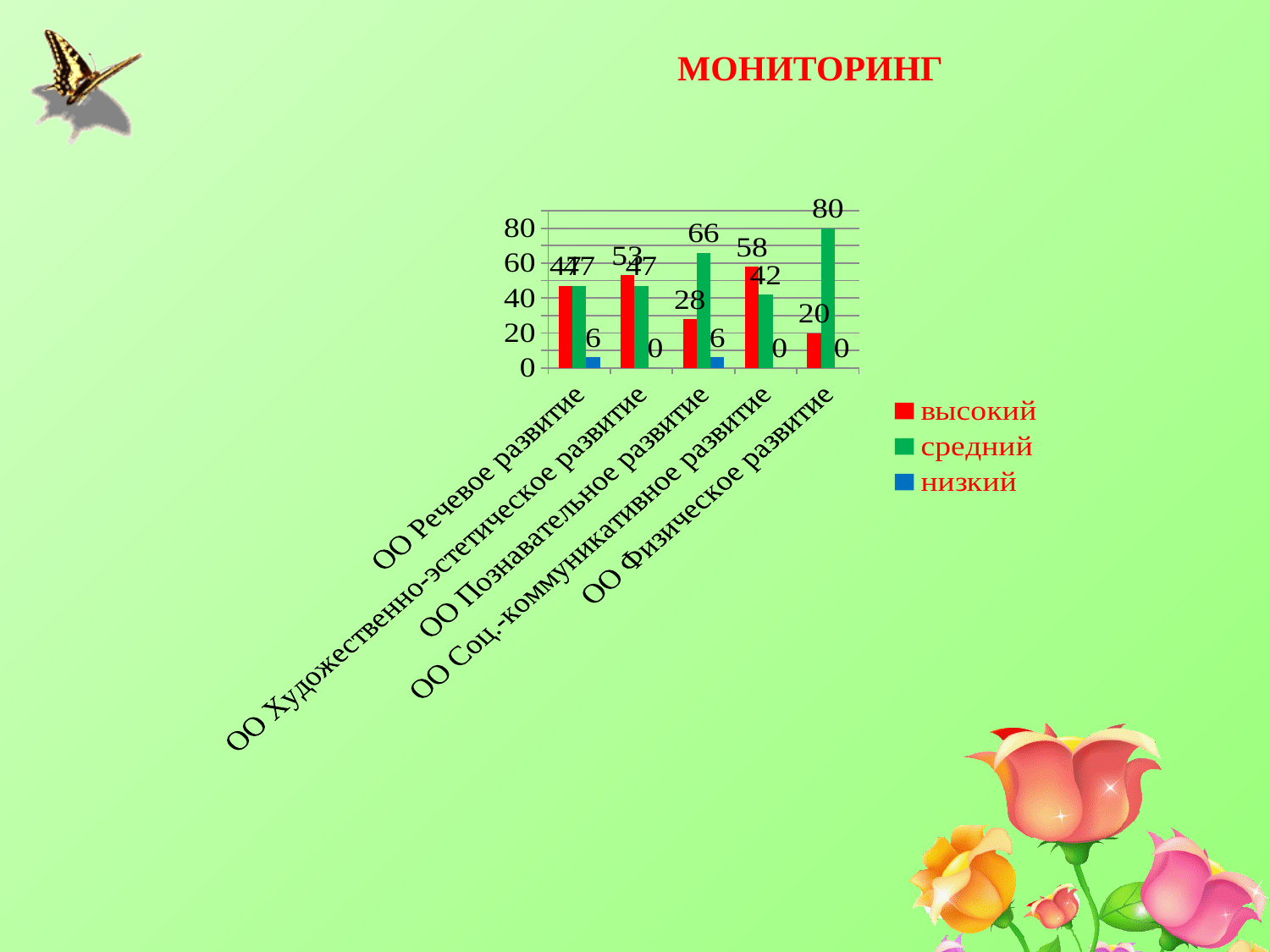
What is the value of высокий for ОО Познавательное развитие? 28 What is the value of высокий for ОО Соц.-коммуникативное развитие? 58 What is the value of средний for ОО Физическое развитие? 80 For ОО Художественно-эстетическое развитие, which is larger: высокий or средний? высокий For ОО Познавательное развитие, what is the difference between средний and высокий? 38 What is the value of низкий for ОО Познавательное развитие? 6 Which category has the lowest value for высокий? ОО Физическое развитие What is the title of the slide above the chart? МОНИТОРИНГ What kind of chart is shown on the slide? bar chart How many series does the legend list? 3 How many categories are shown on the x axis? 5 Which category has the highest value for средний? ОО Физическое развитие